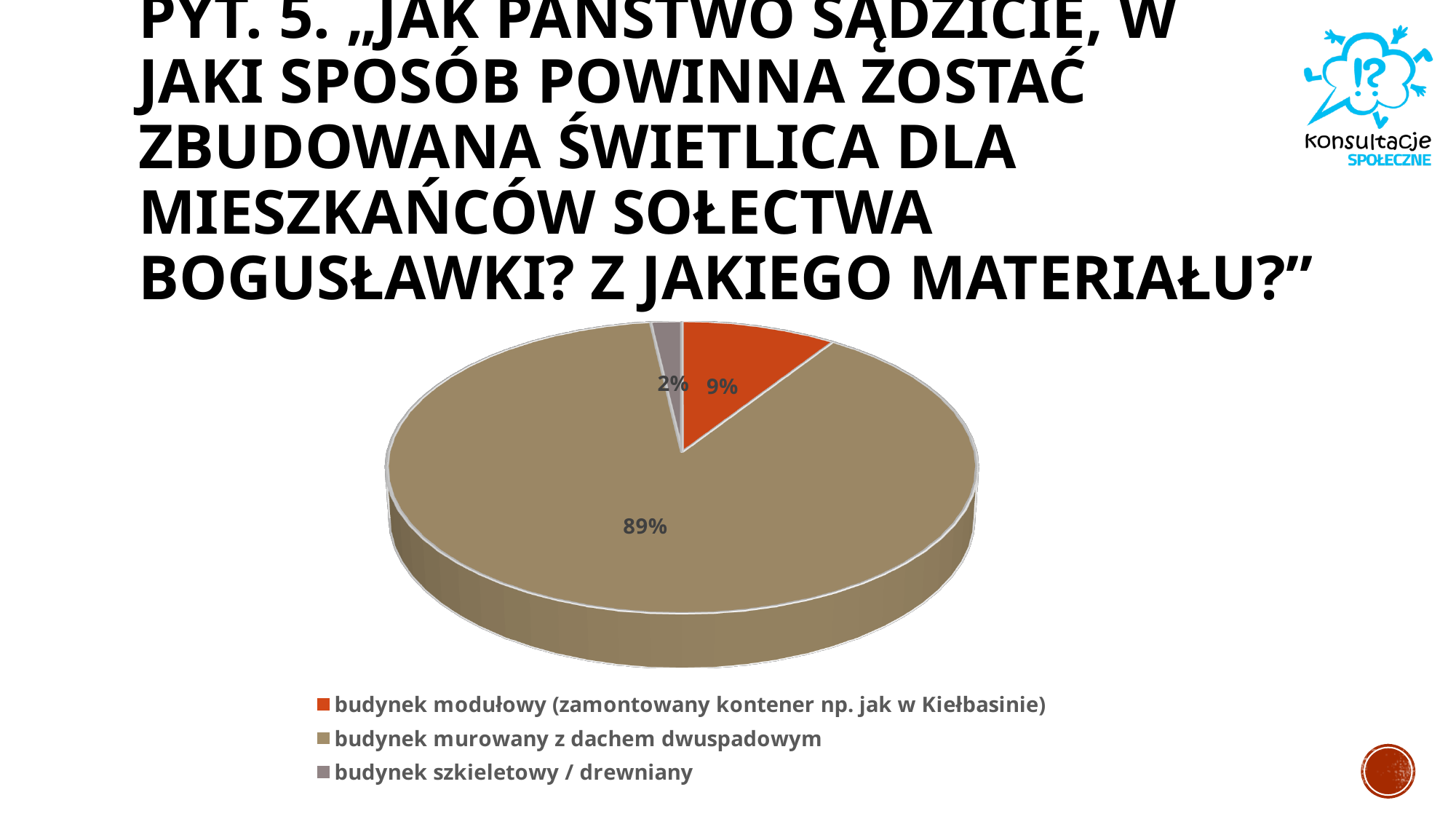
Which category has the smallest slice of the pie? budynek szkieletowy / drewniany Which legend entry is listed last? budynek szkieletowy / drewniany What kind of chart is shown on the slide? pie chart Which category has the largest slice of the pie? budynek murowany z dachem dwuspadowym What share of the pie does 'budynek murowany z dachem dwuspadowym' have? 89% What is the difference in percentage points between 'budynek murowany z dachem dwuspadowym' and 'budynek modułowy (zamontowany kontener np. jak w Kiełbasinie)'? 80 Which is larger: the slice for 'budynek modułowy (zamontowany kontener np. jak w Kiełbasinie)' or the slice for 'budynek szkieletowy / drewniany'? budynek modułowy (zamontowany kontener np. jak w Kiełbasinie) What share of the pie does 'budynek szkieletowy / drewniany' have? 2% What share of the pie does 'budynek modułowy (zamontowany kontener np. jak w Kiełbasinie)' have? 9% What colour is the slice for 'budynek modułowy (zamontowany kontener np. jak w Kiełbasinie)'? orange How many categories does the pie chart show? 3 What is the difference in percentage points between 'budynek modułowy (zamontowany kontener np. jak w Kiełbasinie)' and 'budynek szkieletowy / drewniany'? 7